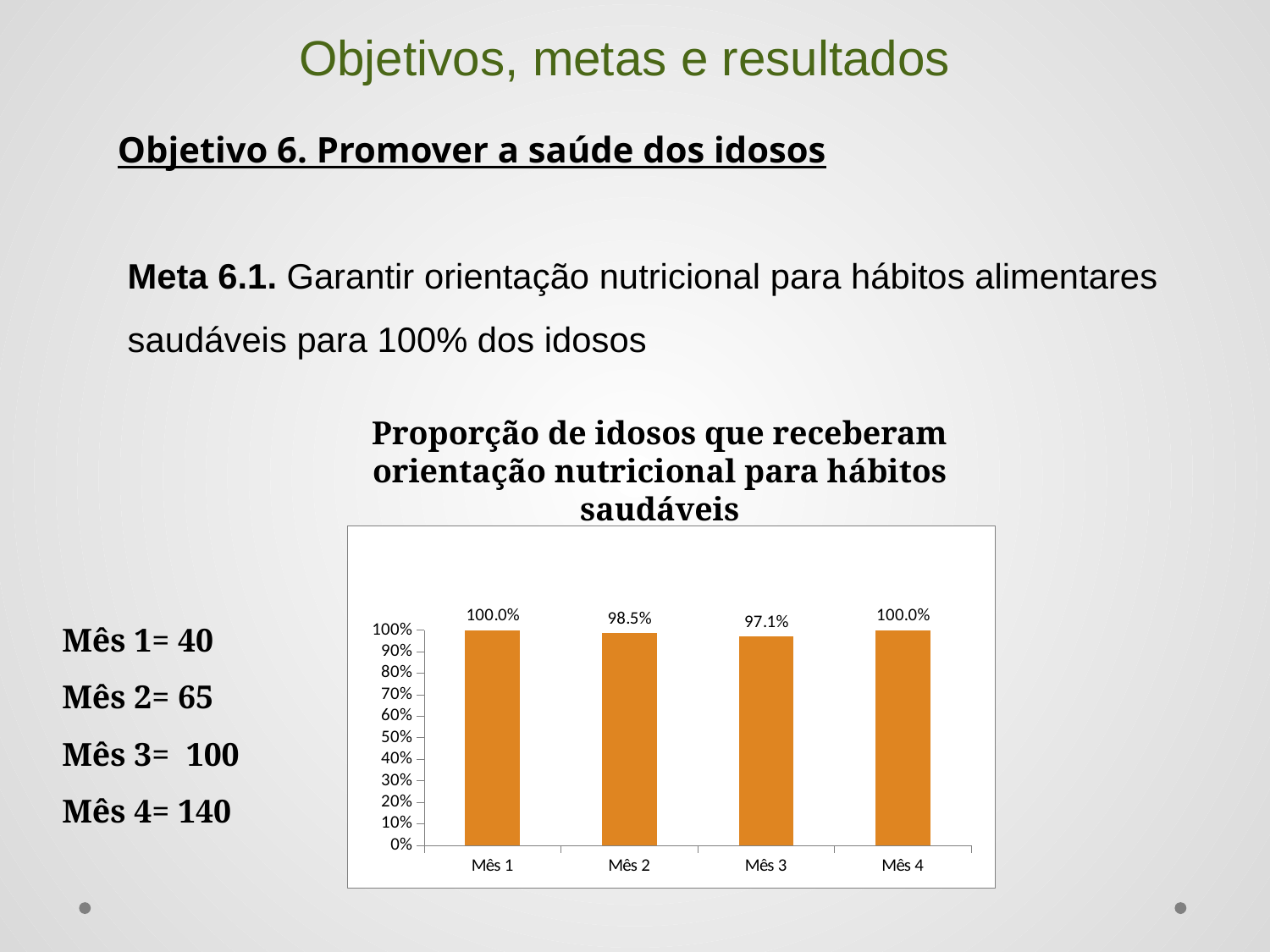
What is the value for Mês 2? 98.5% How many months are shown on the x axis? 4 What colour are the bars in the chart? Orange From Mês 1 to Mês 3, do the values rise or fall? Fall What is the value for Mês 1? 100.0% Is the value for Mês 3 greater or less than 90%? greater What is the value for Mês 3? 97.1% Which month has the lowest value? Mês 3 What is the difference between the values for Mês 2 and Mês 3? 1.4 percentage points What is the difference between the values for Mês 4 and Mês 3? 2.9 percentage points Which is larger, the value for Mês 2 or the value for Mês 3? Mês 2 What kind of chart is shown on the slide? Bar chart